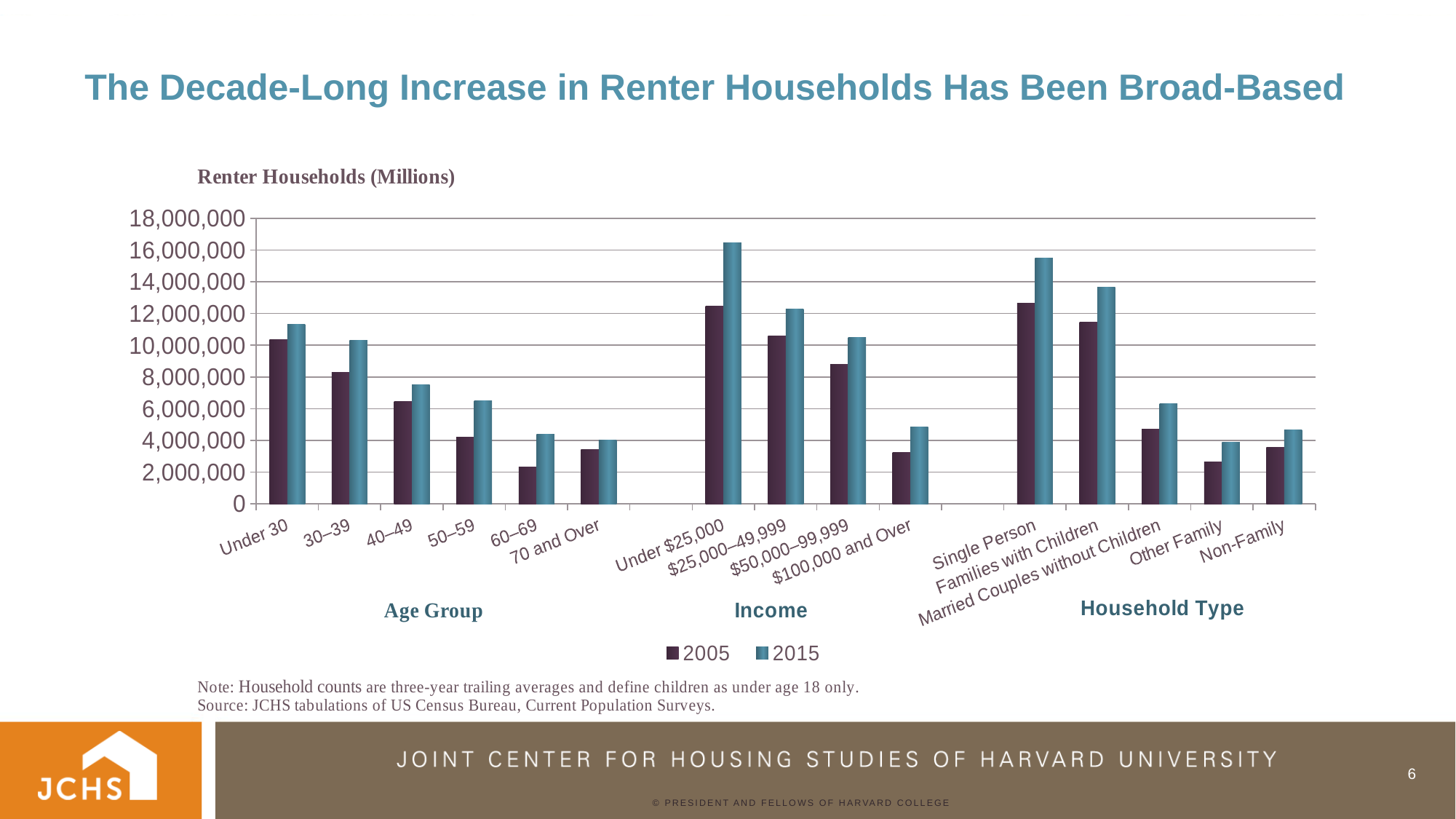
What kind of chart is shown on the slide? Bar chart How many categories are plotted along the x axis in total? 15 Within the Age Group section, do the 2005 values generally rise or fall from Under 30 to 70 and Over? fall Is the 2015 value for Under $25,000 greater or less than 14,000,000? greater How many series does the legend list? 2 Is the 2005 value for 60–69 greater or less than 4,000,000? less What are the two entries in the legend? 2005 and 2015 Which is larger in 2015: Single Person or Families with Children? Single Person Which category has the highest 2015 value? Under $25,000 Within the Age Group section, which age group has the lowest 2005 value? 60–69 Is the 2015 value for Families with Children greater or less than 12,000,000? greater Which is larger in 2005: Under 30 or 30–39? Under 30